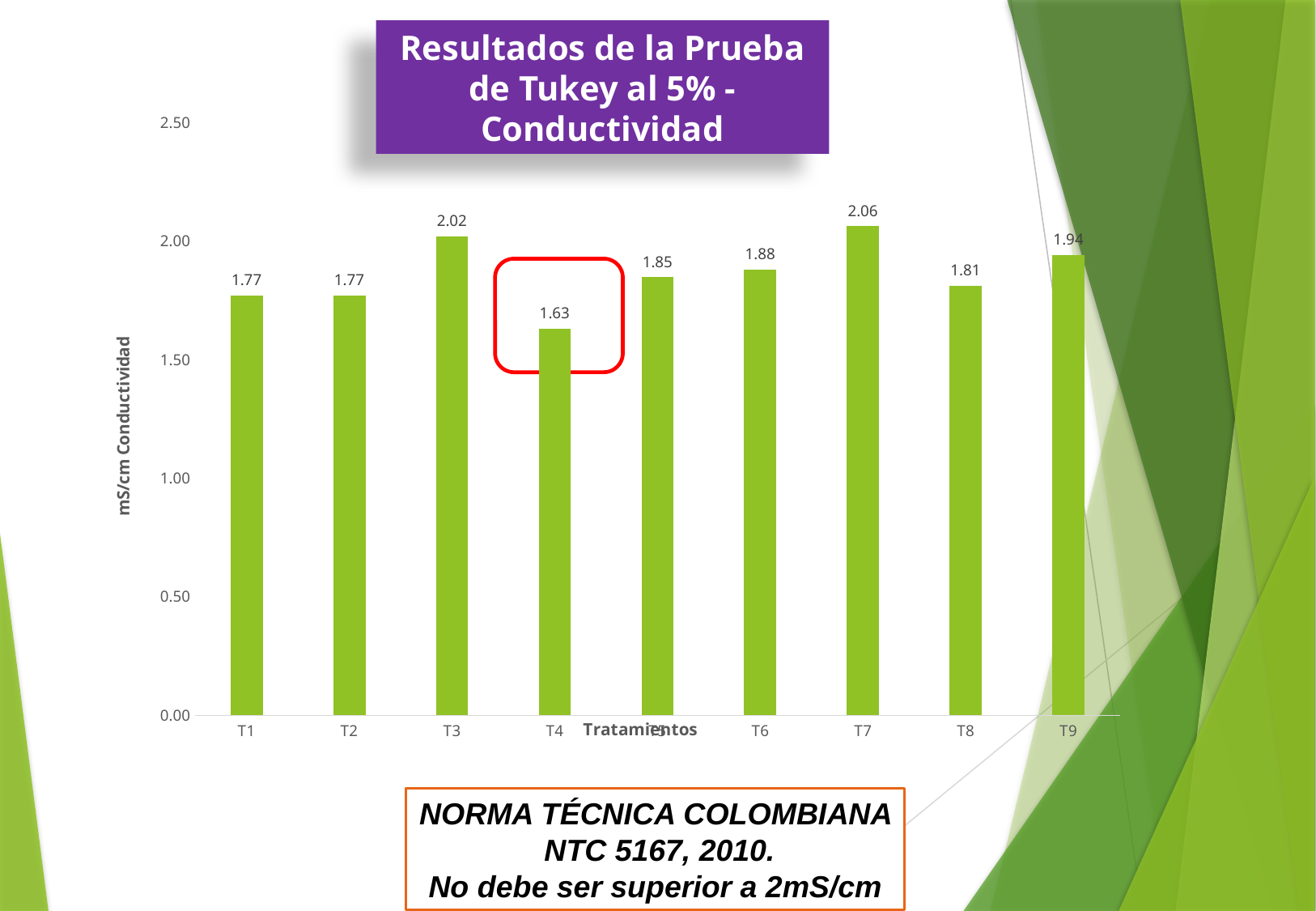
What is the conductivity value for T4? 1.63 What is the conductivity value for T7? 2.06 Which has a higher conductivity, T3 or T6? T3 Which treatment has the lowest conductivity? T4 What is the title of the chart? Resultados de la Prueba de Tukey al 5% - Conductividad How many treatments are shown on the x axis? 9 What is the conductivity value for T9? 1.94 What is the label of the y axis? mS/cm Conductividad What kind of chart is shown on the slide? Bar chart Is the value for T8 greater or less than 2.00? less Which treatment has the highest conductivity? T7 What is the difference in conductivity between T7 and T4? 0.43